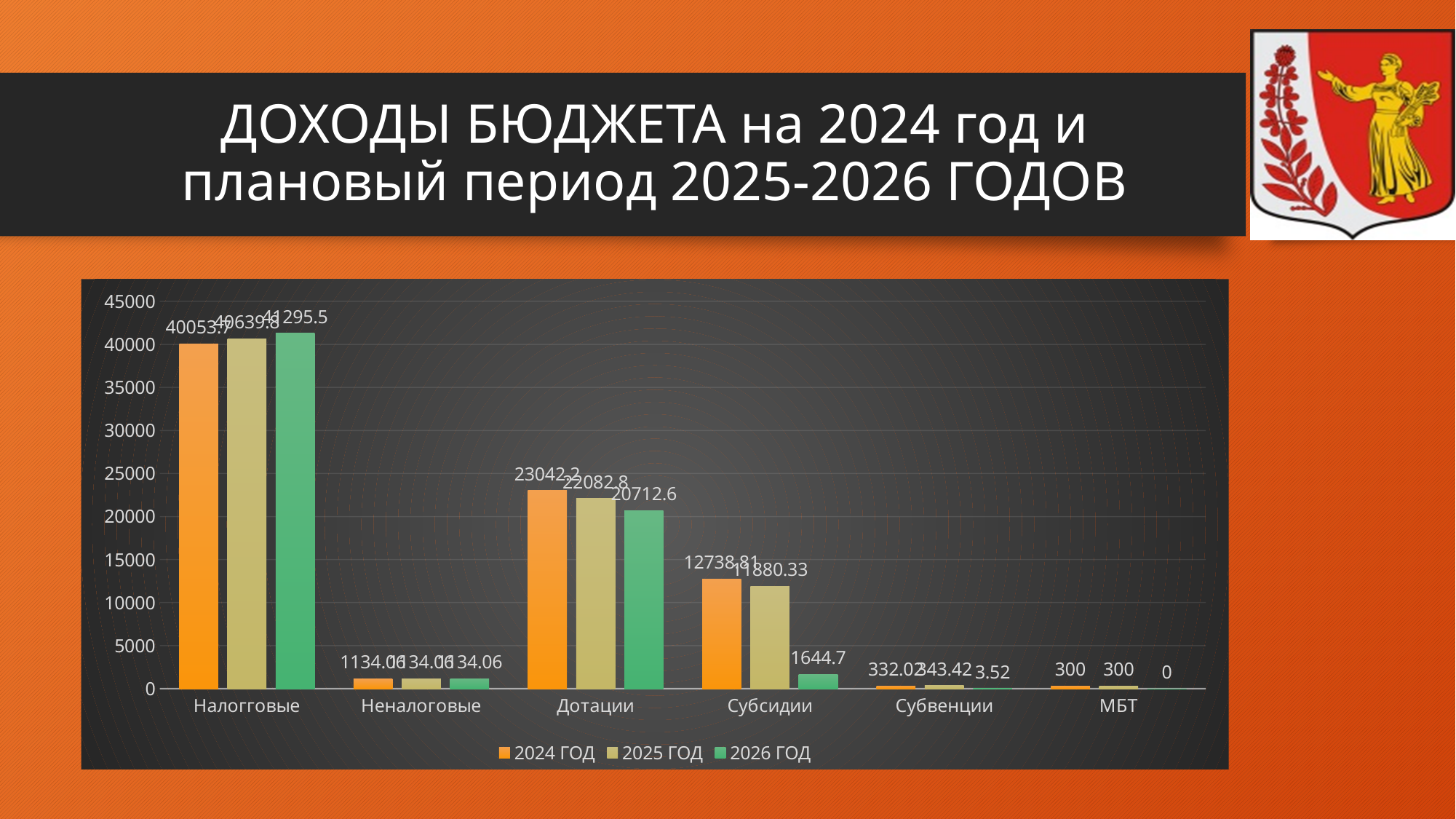
What kind of chart is shown on the slide? bar chart How many series does the legend list? 3 What is the value for Дотации in the 2024 ГОД series? 23042.2 Do the values for Налоговые rise or fall from 2024 ГОД to 2026 ГОД? rise What is the difference between the 2024 ГОД and 2026 ГОД values for Дотации? 2329.6 What is the value for Субсидии in the 2026 ГОД series? 1644.7 Which category has the highest value in the 2024 ГОД series? Налоговые Which category has the lowest value in the 2026 ГОД series? МБТ Which is larger for Субсидии: the 2024 ГОД value or the 2025 ГОД value? 2024 ГОД What is the value for МБТ in the 2026 ГОД series? 0 What is the value for Налоговые in the 2026 ГОД series? 41295.5 How many categories are shown on the x axis? 6